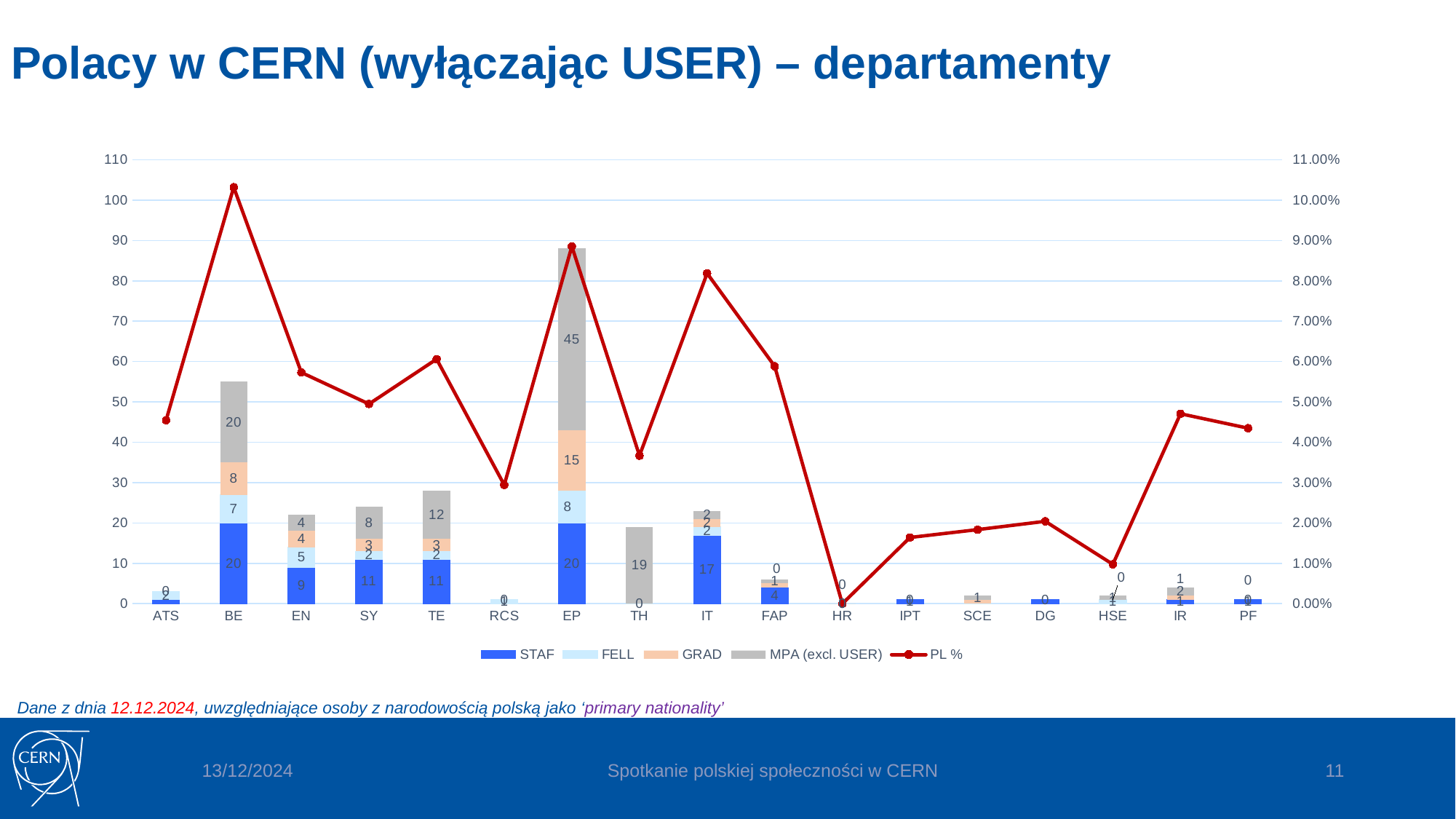
Which department has the highest PL % value on the line? BE Is the PL % value for BE greater or less than 10.00%? greater What is the total of the stacked bar for EP? 88 How many departments are shown on the x axis? 17 What is the difference between the MPA (excl. USER) values for EP and BE? 25 How many series does the legend list? 5 Which is larger, the STAF value for SY or the STAF value for EN? SY What is the STAF value for IT? 17 What is the total of the stacked bar for BE? 55 What is the MPA (excl. USER) value for EP? 45 What is the GRAD value for BE? 8 What kind of chart is shown on the slide? A combined bar and line chart (stacked bars with a line)